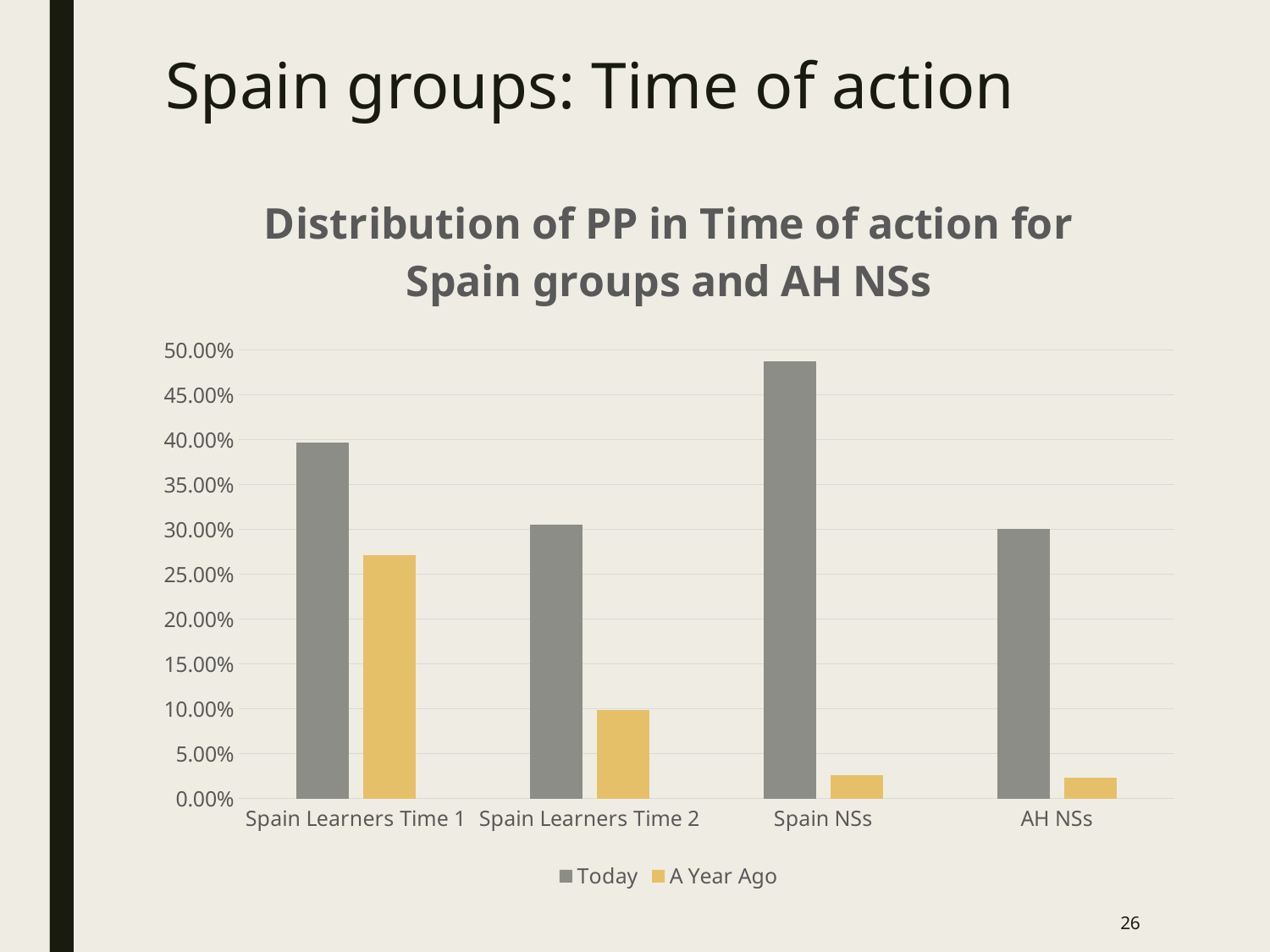
Which is larger for the Today series: Spain NSs or Spain Learners Time 2? Spain NSs Which category has the highest value for the A Year Ago series? Spain Learners Time 1 Is the A Year Ago value for Spain Learners Time 2 greater or less than 15.00%? less What kind of chart is shown on the slide? bar chart How many series does the chart's legend list? 2 What are the two series named in the chart's legend? Today and A Year Ago Is the Today value for Spain NSs greater or less than 45.00%? greater For Spain Learners Time 1, which series has the larger value, Today or A Year Ago? Today How many categories are shown on the x axis of the chart? 4 Is the Today value for Spain Learners Time 1 greater or less than 35.00%? greater Which category has the highest value for the Today series? Spain NSs